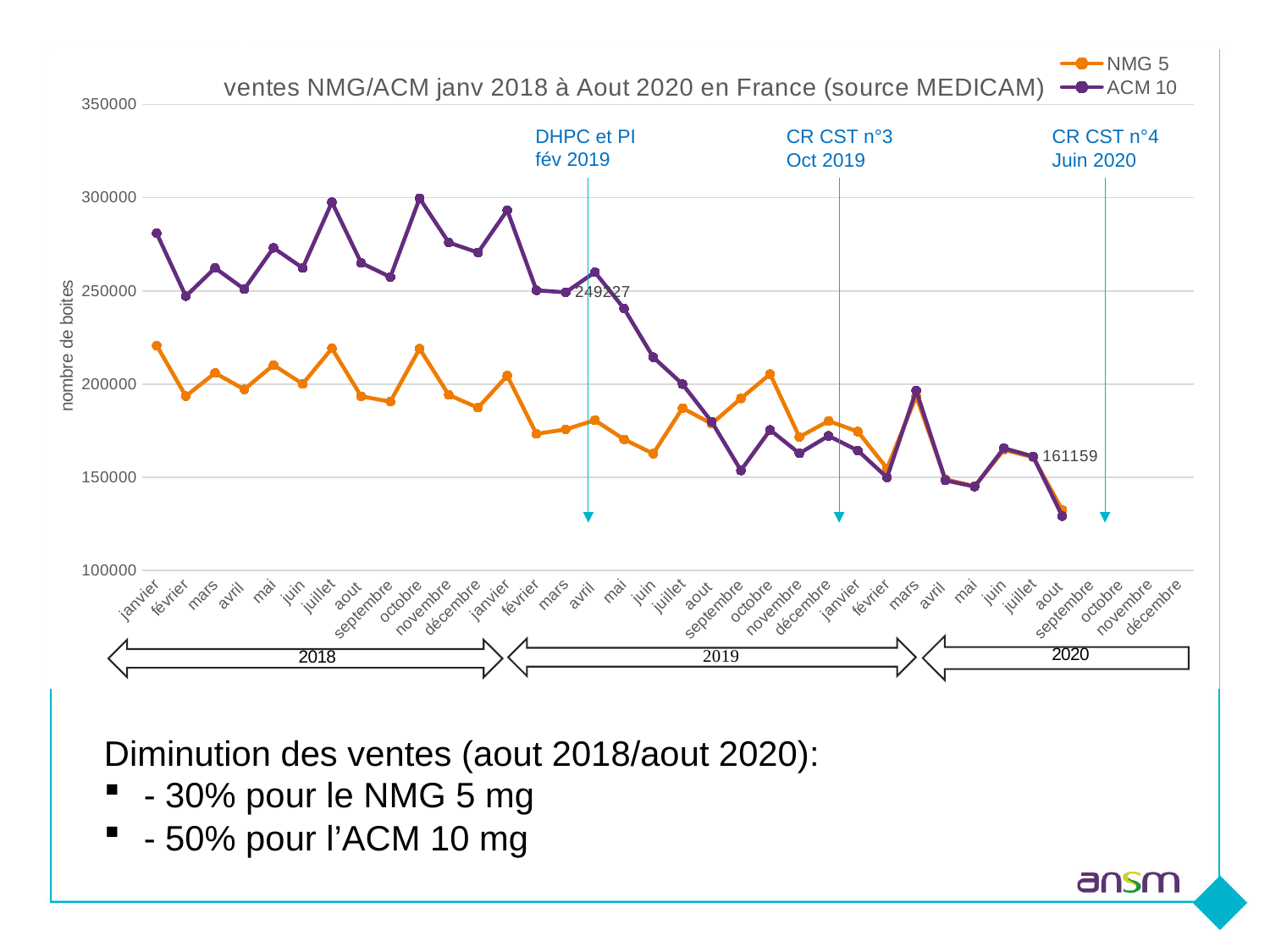
What are the two series named in the legend? NMG 5 and ACM 10 Does the ACM 10 line rise or fall between janvier 2019 and septembre 2019? fall What kind of chart is shown on the slide? line chart Is the value for ACM 10 in janvier 2018 greater or less than 250000? greater In janvier 2018, which series has the higher value, NMG 5 or ACM 10? ACM 10 What data label is printed on the ACM 10 line around mars 2019? 249227 How many series does the legend list? 2 Which series reaches the highest value anywhere on the chart? ACM 10 Is the value for ACM 10 in aout 2020 greater or less than 150000? less What data label is printed next to the juillet 2020 point? 161159 Is the value for NMG 5 in janvier 2018 greater or less than 200000? greater What is the title of the chart? ventes NMG/ACM janv 2018 à Aout 2020 en France (source MEDICAM)